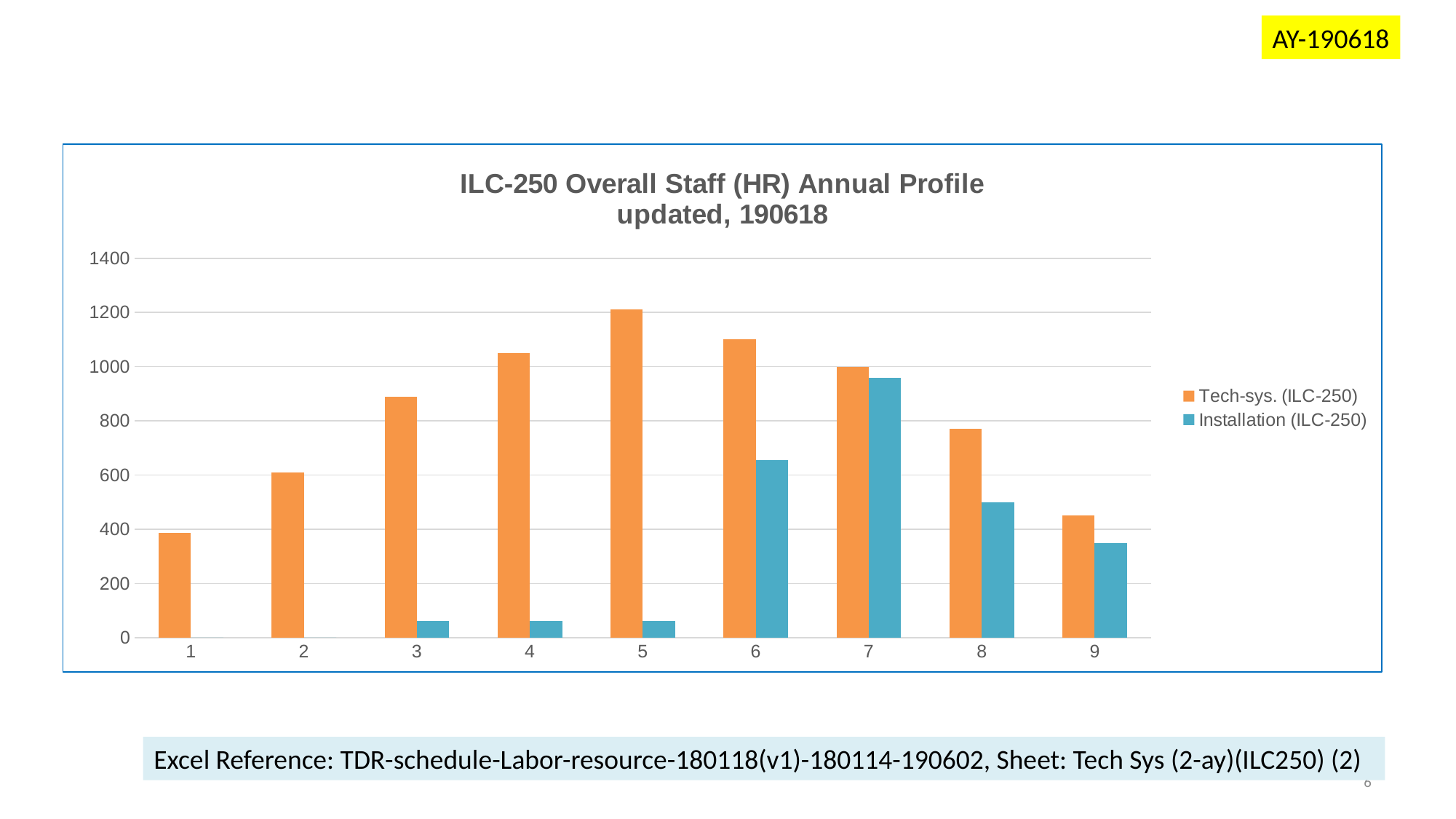
Is the Installation (ILC-250) value for category 6 greater or less than 600? greater In category 6, which series has the larger value, Tech-sys. (ILC-250) or Installation (ILC-250)? Tech-sys. (ILC-250) In which category does Installation (ILC-250) reach its highest value? 7 Is the Installation (ILC-250) value for category 9 greater or less than 400? less How many categories are shown on the x axis? 9 Do the Tech-sys. (ILC-250) values rise or fall from category 5 to category 9? fall What kind of chart is shown on the slide? bar chart In which category does Tech-sys. (ILC-250) reach its highest value? 5 In which category is Tech-sys. (ILC-250) lowest? 1 How many series does the legend list? 2 Is the Tech-sys. (ILC-250) value for category 4 greater or less than 1000? greater